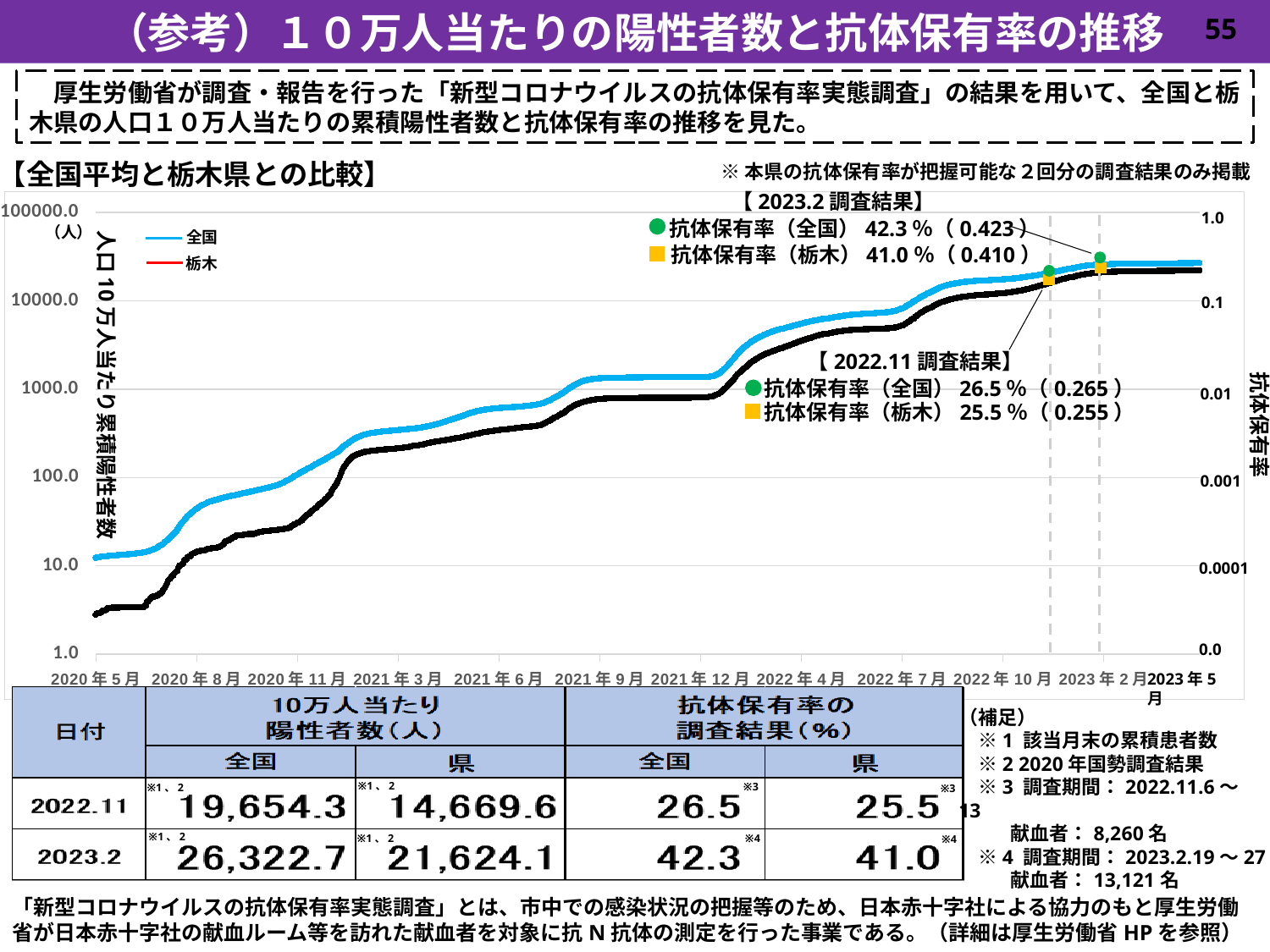
By how much did the 全国 antibody prevalence rate increase from the 2022.11 survey to the 2023.2 survey? 15.8% What is the label of the right-hand vertical axis? 抗体保有率 What kind of chart is shown on the slide? line chart According to the chart annotation, what was the antibody prevalence rate (抗体保有率) for 全国 in the 2023.2 survey? 42.3% Which series has the higher cumulative positive cases per 100,000 people throughout the chart, 全国 or 栃木? 全国 Do the cumulative positive case lines rise or fall from 2020年5月 to 2023年5月? rise According to the chart annotation, what was the antibody prevalence rate for 栃木 in the 2022.11 survey? 25.5% How many series does the chart legend list? 2 Is the value for 栃木 at 2020年11月 greater or less than 100.0? less What is the difference between the 全国 and 栃木 antibody prevalence rates in the 2023.2 survey? 1.3% According to the chart annotation, what was the antibody prevalence rate (抗体保有率) for 栃木 in the 2023.2 survey? 41.0% According to the chart annotation, what was the antibody prevalence rate for 全国 in the 2022.11 survey? 26.5%